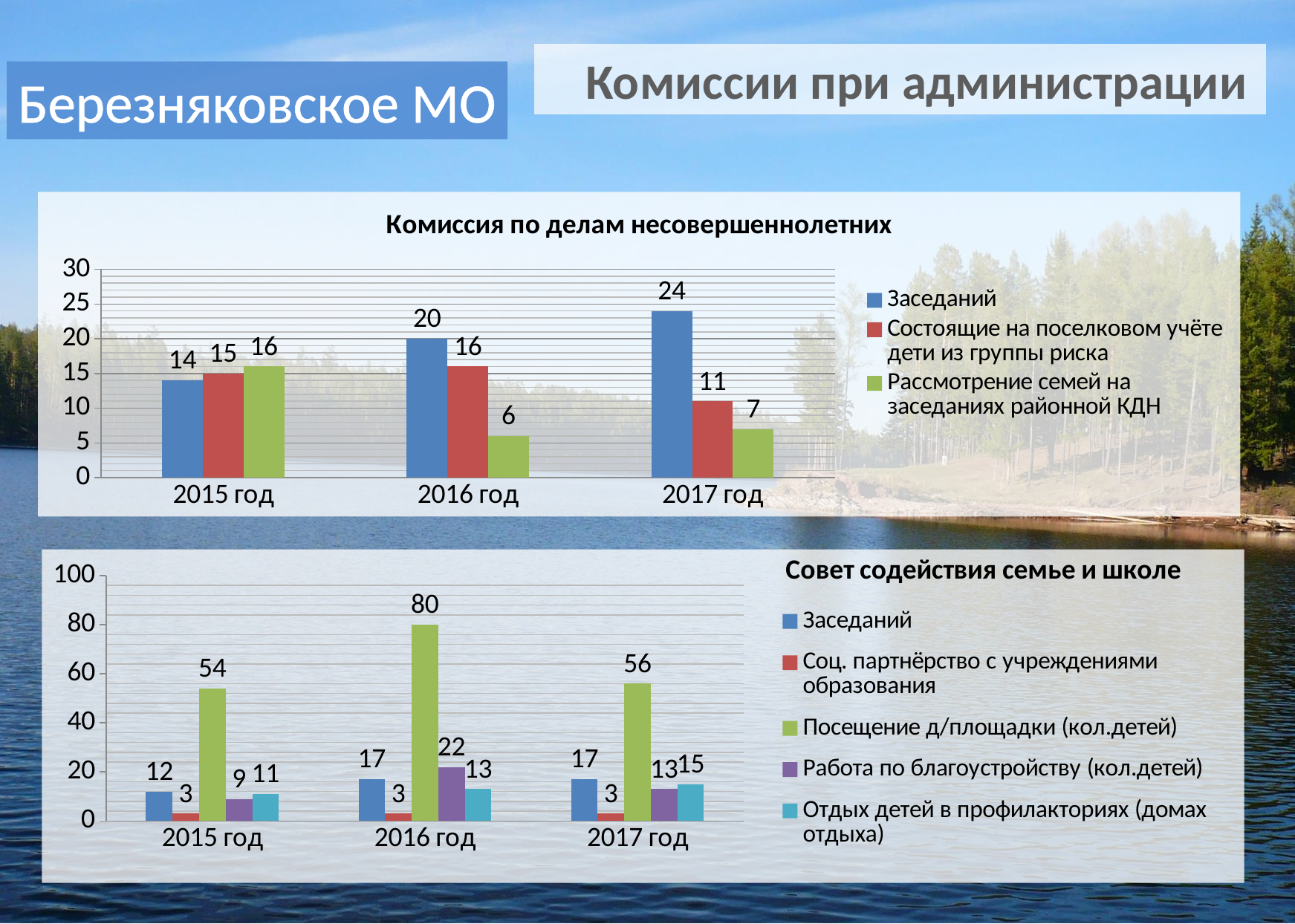
How many series does the legend of the chart 'Комиссия по делам несовершеннолетних' list? 3 In the chart 'Комиссия по делам несовершеннолетних', does the value for 'Заседаний' rise or fall from 2015 год to 2017 год? rise In the chart 'Комиссия по делам несовершеннолетних', what is the difference between 'Заседаний' in 2017 год and in 2015 год? 10 In the chart 'Совет содействия семье и школе', what is the value for 'Посещение д/площадки (кол.детей)' in 2016 год? 80 In the chart 'Комиссия по делам несовершеннолетних', in which year is the value for 'Заседаний' highest? 2017 год How many series does the legend of the chart 'Совет содействия семье и школе' list? 5 In the chart 'Совет содействия семье и школе', what is the value for 'Работа по благоустройству (кол.детей)' in 2015 год? 9 In the chart 'Комиссия по делам несовершеннолетних', what is the value for 'Рассмотрение семей на заседаниях районной КДН' in 2016 год? 6 What kind of chart is the chart 'Совет содействия семье и школе'? bar chart In the chart 'Совет содействия семье и школе', which is larger: 'Отдых детей в профилакториях (домах отдыха)' in 2017 год or 'Работа по благоустройству (кол.детей)' in 2017 год? Отдых детей в профилакториях (домах отдыха) In the chart 'Комиссия по делам несовершеннолетних', what is the value for 'Заседаний' in 2017 год? 24 In the chart 'Совет содействия семье и школе', which series has the lowest value in 2017 год? Соц. партнёрство с учреждениями образования